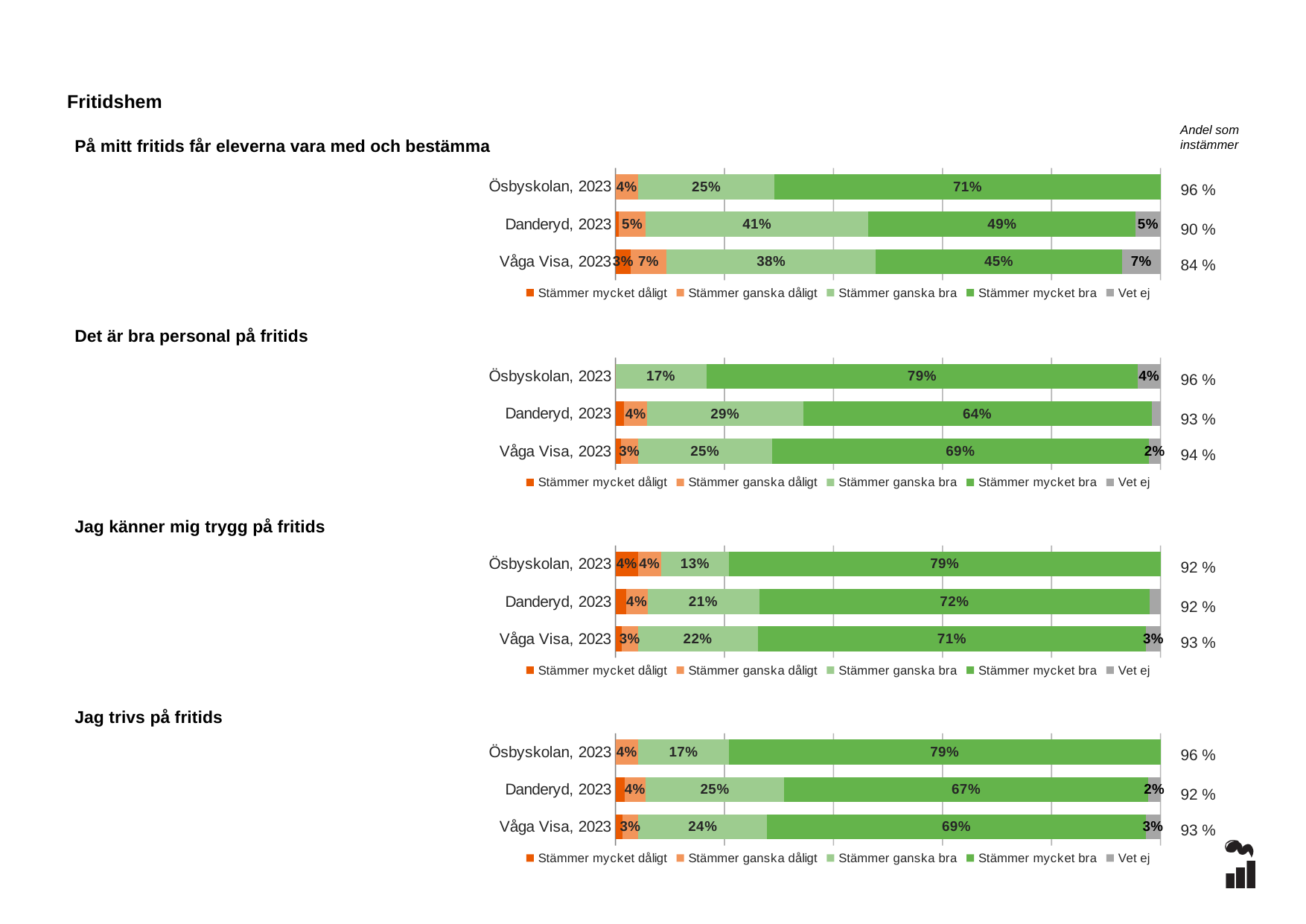
In the chart 'På mitt fritids får eleverna vara med och bestämma', what is the 'Stämmer ganska bra' value for Danderyd, 2023? 41% How many rows (categories) are shown in the chart 'Det är bra personal på fritids'? 3 In the chart 'Det är bra personal på fritids', what is the difference between the 'Stämmer mycket bra' values for Ösbyskolan, 2023 and Våga Visa, 2023? 10% In the chart 'På mitt fritids får eleverna vara med och bestämma', which row has the lowest 'Stämmer mycket bra' value? Våga Visa, 2023 In the chart 'Jag känner mig trygg på fritids', which is larger: the 'Stämmer mycket bra' value for Danderyd, 2023 or for Våga Visa, 2023? Danderyd, 2023 What kind of chart is 'Jag känner mig trygg på fritids'? Stacked bar chart How many series does the legend of the chart 'Jag trivs på fritids' list? 5 In the chart 'Det är bra personal på fritids', what is the 'Stämmer mycket bra' value for Danderyd, 2023? 64% In the chart 'Jag känner mig trygg på fritids', what is the 'Stämmer ganska bra' value for Ösbyskolan, 2023? 13% In the chart 'På mitt fritids får eleverna vara med och bestämma', what is the 'Stämmer mycket bra' value for Ösbyskolan, 2023? 71% In the chart 'Jag trivs på fritids', what is the 'Vet ej' value for Våga Visa, 2023? 3% In the chart 'Jag trivs på fritids', what is the 'Stämmer mycket bra' value for Ösbyskolan, 2023? 79%